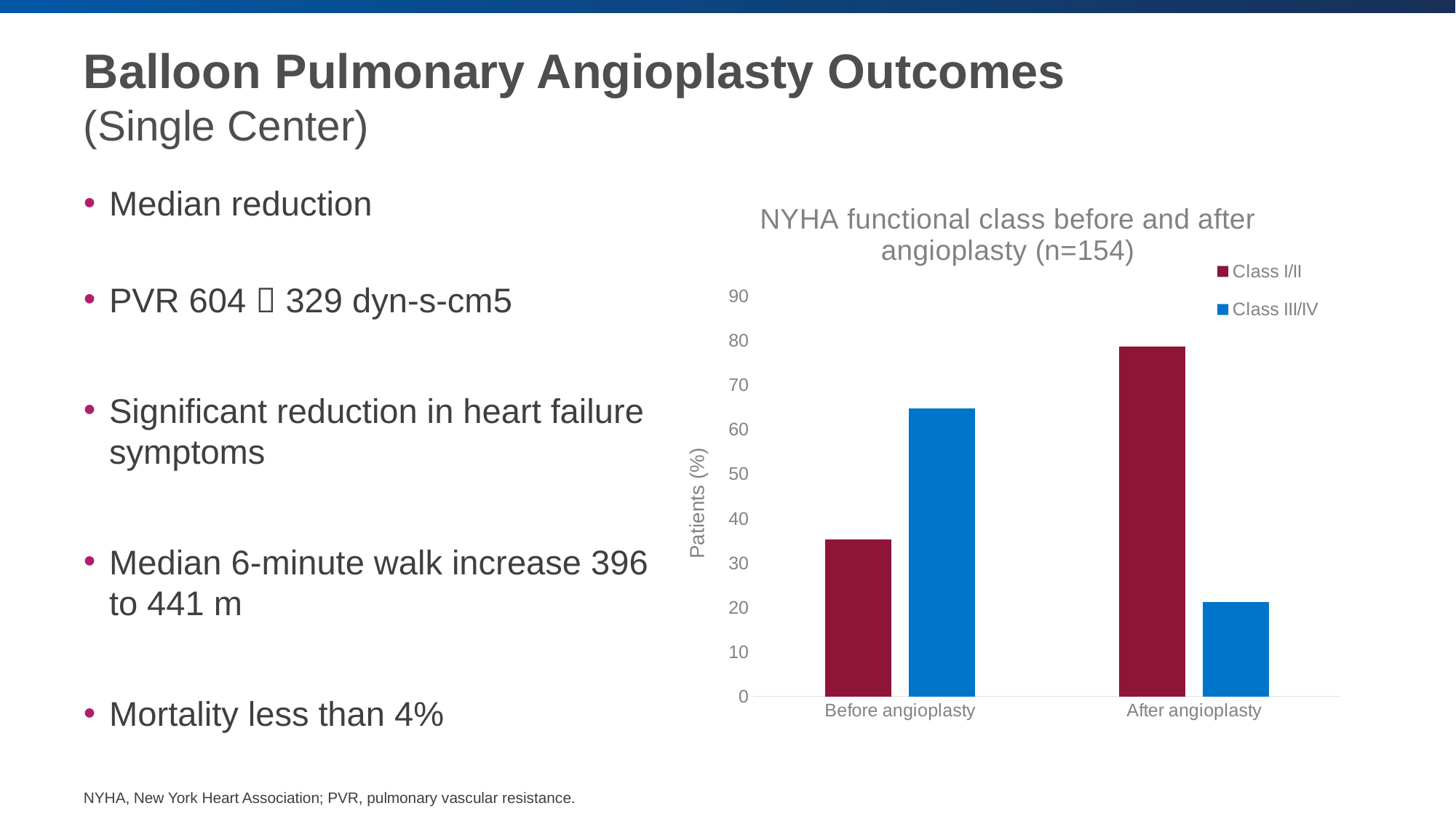
What is the title of the chart? NYHA functional class before and after angioplasty (n=154) Is the value for Class I/II after angioplasty greater or less than 70? greater Which is larger after angioplasty: Class I/II or Class III/IV? Class I/II Which bar in the chart is the tallest? Class I/II after angioplasty Is the value for Class III/IV before angioplasty greater or less than 60? greater Is the value for Class III/IV after angioplasty greater or less than 30? less How many series does the chart legend list? 2 What kind of chart is shown on the slide? bar chart What is the label of the chart's y axis? Patients (%) How many categories are shown on the x axis of the chart? 2 Which is larger before angioplasty: Class I/II or Class III/IV? Class III/IV